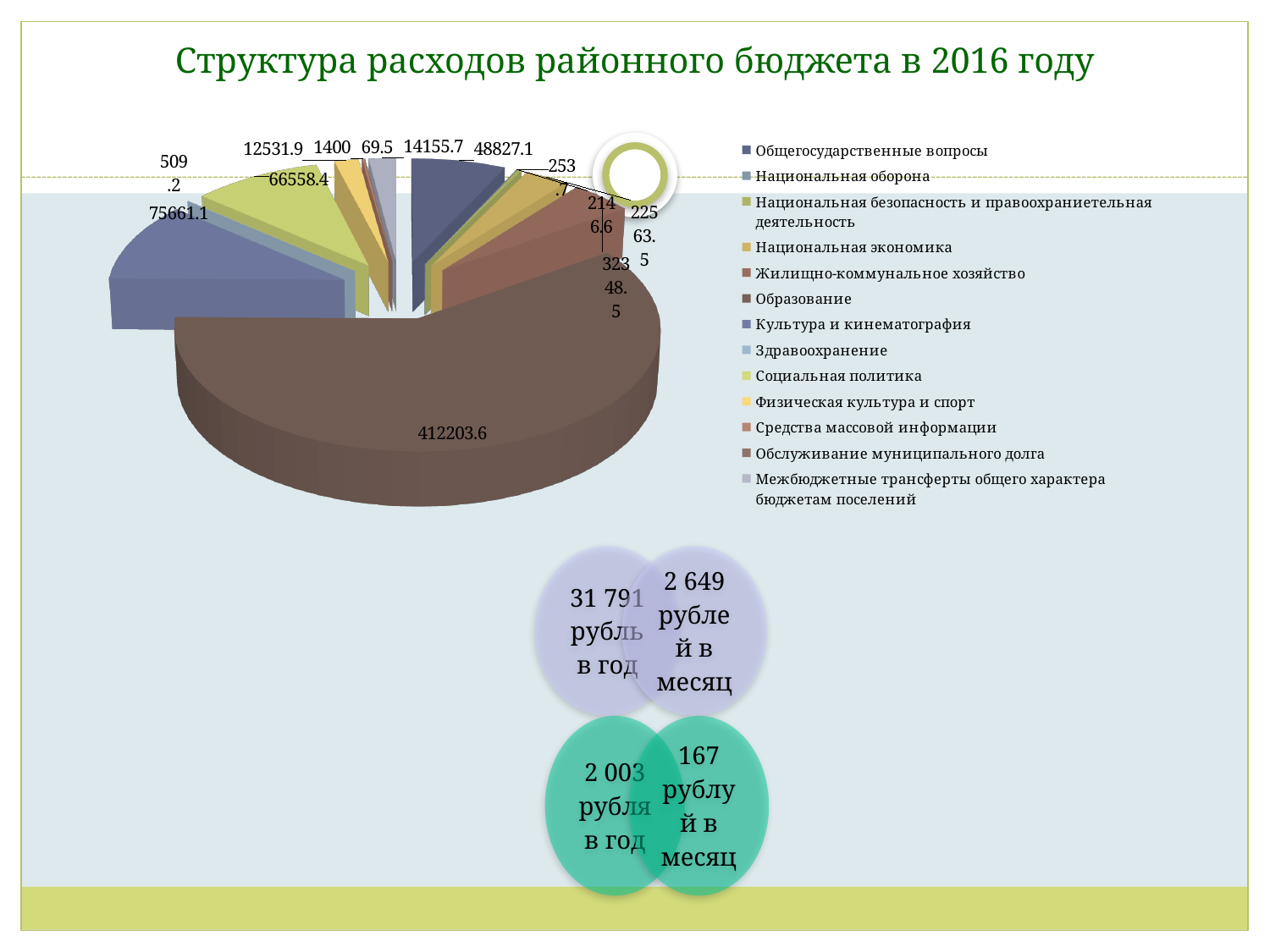
What colour is the largest slice of the pie? brown Which category has the largest slice of the pie? Образование What is the value shown for Социальная политика? 66558.4 What is the value shown for Культура и кинематография? 75661.1 Which is larger, the slice labelled 412203.6 or the slice labelled 75661.1? 412203.6 What is the title of the chart? Структура расходов районного бюджета в 2016 году What kind of chart is shown on the slide? pie chart How many categories does the chart's legend list? 13 What is the smallest data label shown on the pie chart? 69.5 What is the value shown for Образование? 412203.6 What is the difference between the slice labelled 412203.6 and the slice labelled 75661.1? 336542.5 Which is larger, the slice labelled 66558.4 or the slice labelled 12531.9? 66558.4